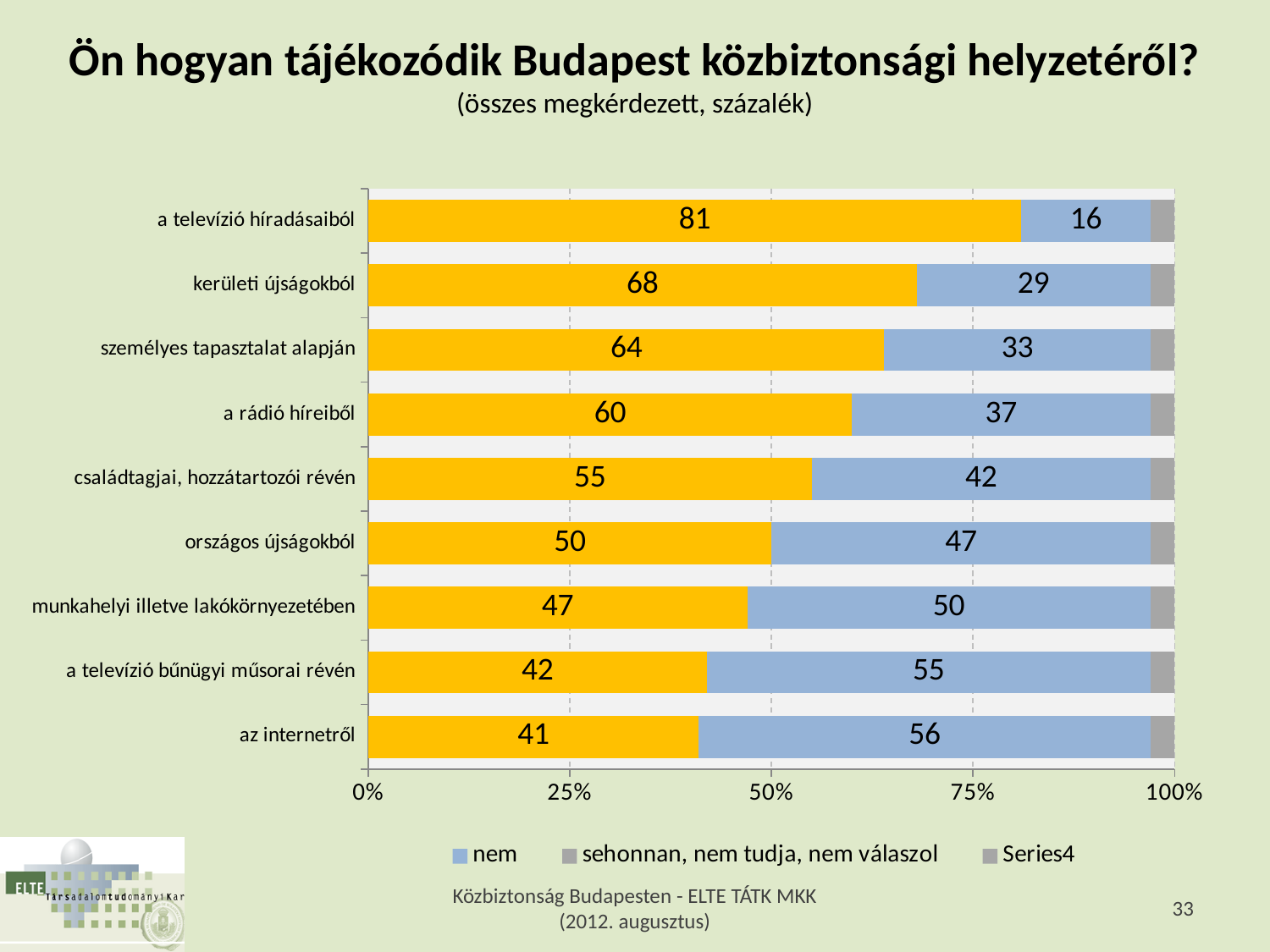
Which has a larger 'nem' value: 'kerületi újságokból' or 'a rádió híreiből'? a rádió híreiből Which category has the lowest value in the yellow series? az internetről What is the value of the yellow segment for 'a rádió híreiből'? 60 How many categories are shown on the chart? 9 What kind of chart is shown on the slide? stacked bar chart Does the yellow segment for 'a televízió híradásaiból' extend to greater or less than 75%? greater Which category has the highest value in the yellow series? a televízió híradásaiból How many series does the legend list? 3 What is the value of the 'nem' segment for 'az internetről'? 56 Which category has the highest 'nem' value? az internetről What is the difference between the yellow value and the 'nem' value for 'a televízió híradásaiból'? 65 What is the value of the 'nem' segment for 'családtagjai, hozzátartozói révén'? 42